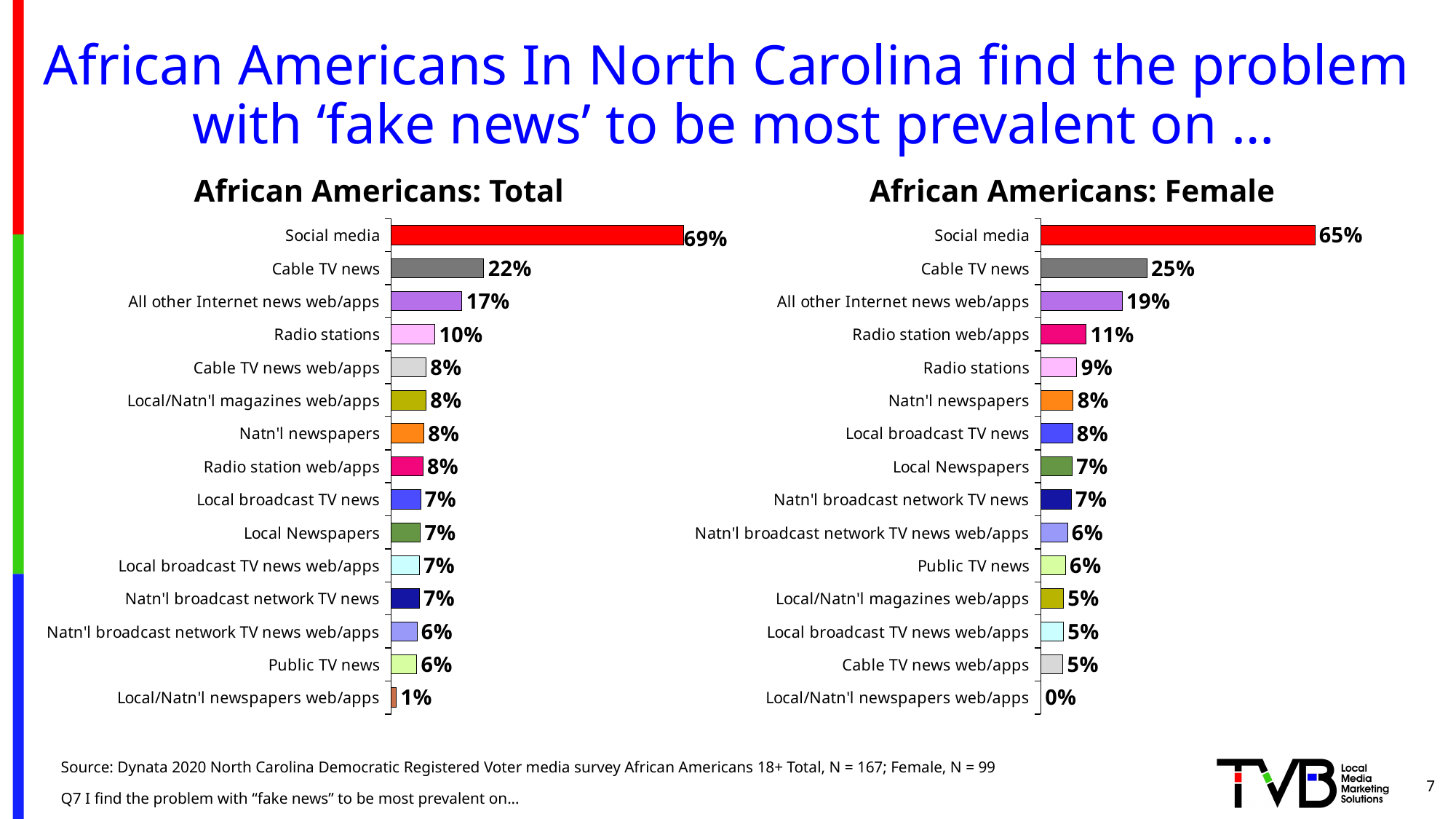
In the 'African Americans: Total' chart, what is the difference between Social media and Cable TV news? 47% In the 'African Americans: Female' chart, what is the value for Cable TV news? 25% In the 'African Americans: Female' chart, which category has the lowest value? Local/Natn'l newspapers web/apps Which is larger: Social media in the 'African Americans: Total' chart or Social media in the 'African Americans: Female' chart? African Americans: Total What type of chart is the 'African Americans: Female' chart? Bar chart In the 'African Americans: Female' chart, what is the value for All other Internet news web/apps? 19% In the 'African Americans: Female' chart, what is the difference between Cable TV news and All other Internet news web/apps? 6% What is the title of the chart on the left side of the slide? African Americans: Total How many categories are shown in the 'African Americans: Total' chart? 15 In the 'African Americans: Total' chart, what is the value for Social media? 69% In the 'African Americans: Total' chart, what is the value for Radio stations? 10% In the 'African Americans: Total' chart, which category has the highest value? Social media